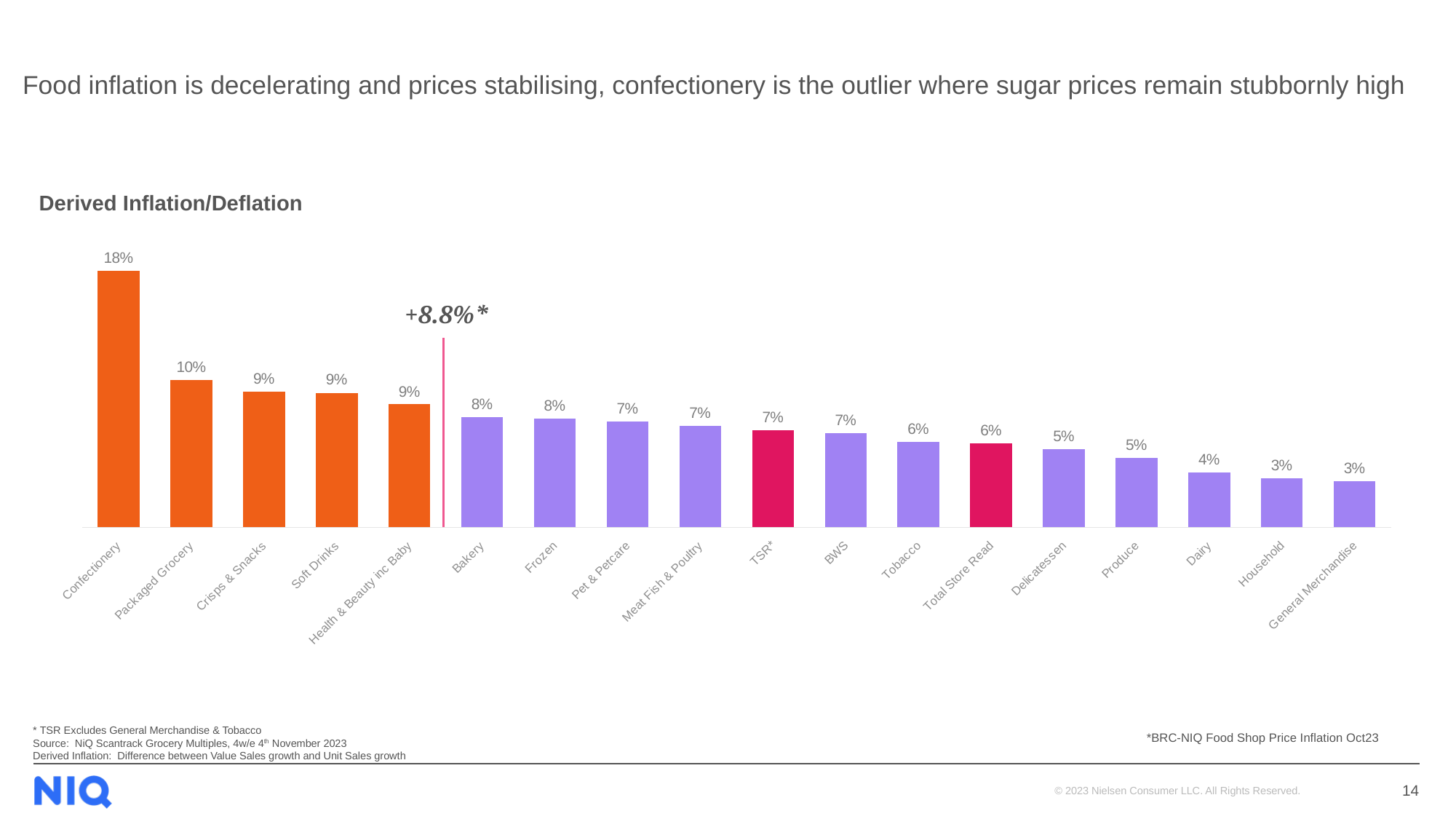
What is the difference between the derived inflation for Bakery and Produce? 3% How many categories are shown in the chart? 18 Which has a higher derived inflation value, Tobacco or Household? Tobacco Do the values rise or fall from left to right across the chart? Fall What is the difference between the derived inflation for Confectionery and Packaged Grocery? 8% What is the derived inflation value for Packaged Grocery? 10% Which category has the highest derived inflation? Confectionery What is the title of the chart? Derived Inflation/Deflation What is the derived inflation value for Confectionery? 18% What is the derived inflation value for Total Store Read? 6% What is the derived inflation value for Dairy? 4% What kind of chart is shown on the slide? Bar chart